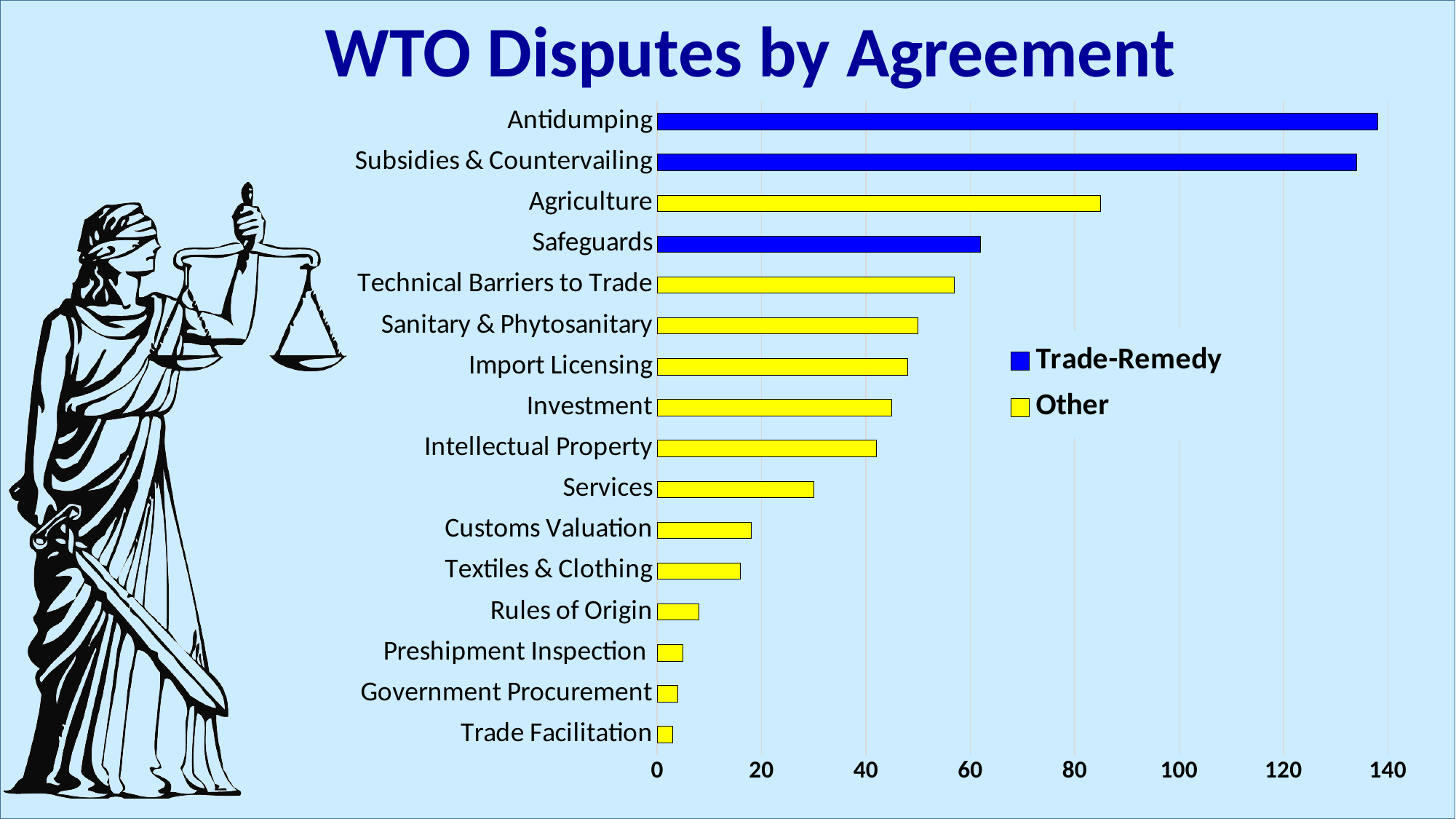
Which agreement has the highest number of disputes? Antidumping Which agreement has the lowest number of disputes? Trade Facilitation Which has more disputes, Agriculture or Safeguards? Agriculture Is the value for Antidumping greater or less than 120? greater How many agreement categories are plotted in the chart? 16 Is the value for Services greater or less than 40? less What is the title of the chart? WTO Disputes by Agreement Which legend series is shown in blue? Trade-Remedy Is the value for Agriculture greater or less than 80? greater What kind of chart is shown on the slide? bar chart How many series does the legend list? 2